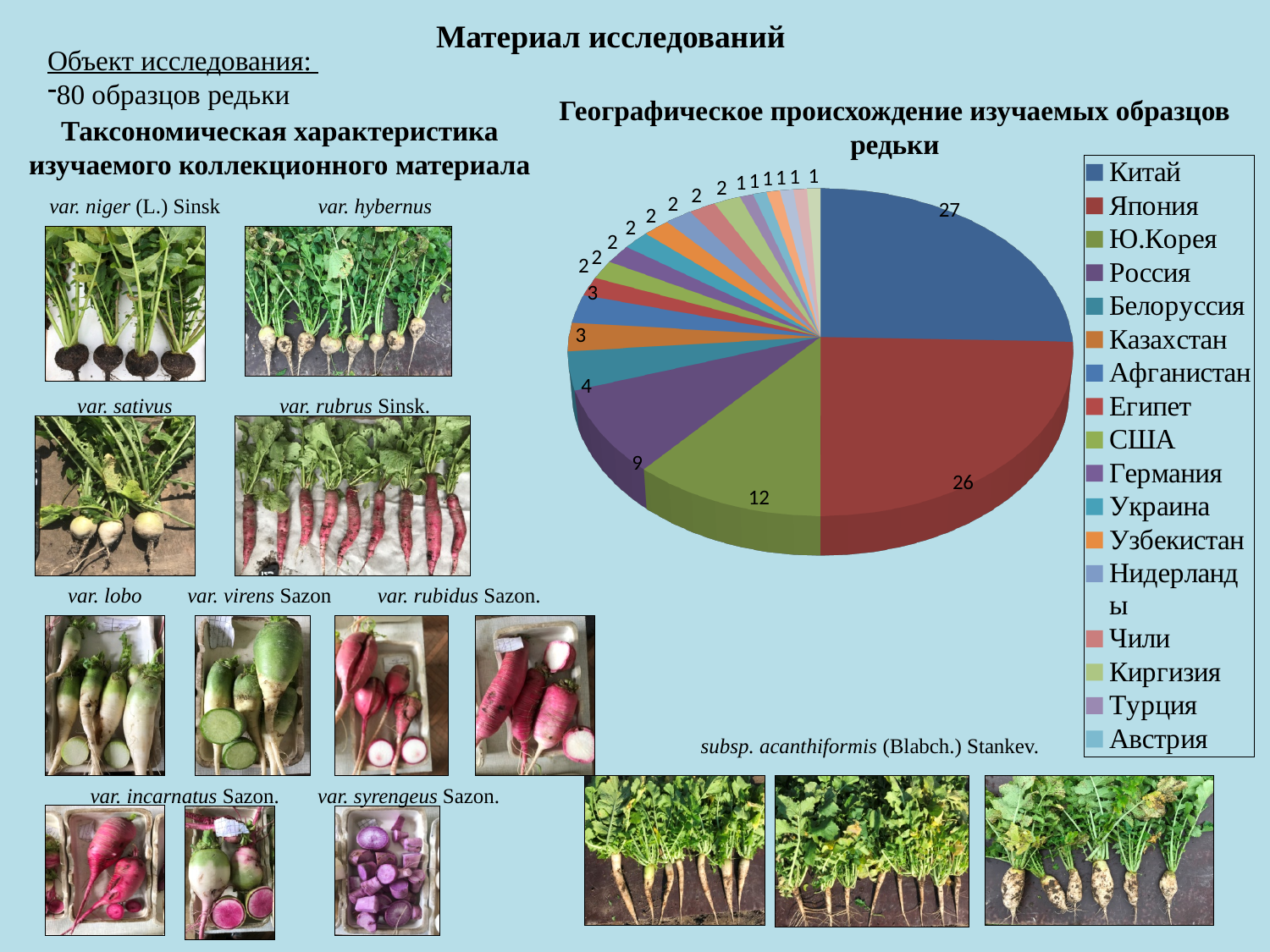
What is the value for Китай in the pie chart? 27 What is the value for Япония in the pie chart? 26 What type of chart is shown under the title "Географическое происхождение изучаемых образцов редьки"? pie chart Which is larger in the pie chart, the value for Китай or the value for Япония? Китай What is the difference between the values for Китай and Япония in the pie chart? 1 What is the difference between the values for Ю.Корея and Россия in the pie chart? 3 What is the value for Белоруссия in the pie chart? 4 What is the value for Ю.Корея in the pie chart? 12 Which country has the largest slice in the pie chart? Китай What is the title of the pie chart? Географическое происхождение изучаемых образцов редьки How many countries are listed in the legend of the pie chart? 17 What is the value for Россия in the pie chart? 9